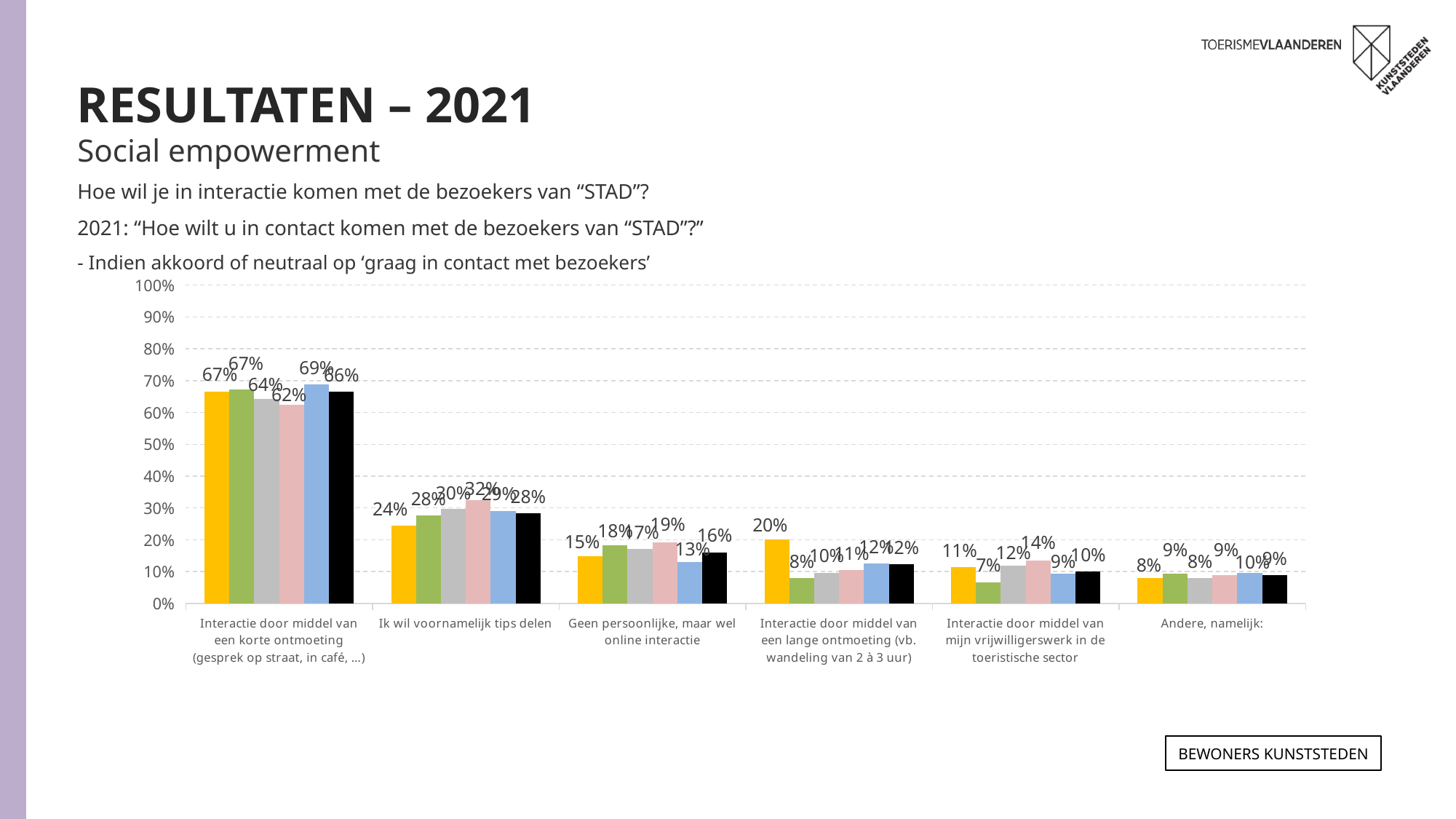
How many bars are plotted for each category in the chart? 6 How many categories are shown along the x axis of the chart? 6 What is the value of the yellow (first) bar for 'Ik wil voornamelijk tips delen'? 24% What is the value of the pink bar for 'Interactie door middel van mijn vrijwilligerswerk in de toeristische sector'? 14% Which category has the highest values across all bars? Interactie door middel van een korte ontmoeting (gesprek op straat, in café, ...) What is the value of the yellow (first) bar for 'Interactie door middel van een lange ontmoeting (vb. wandeling van 2 à 3 uur)'? 20% What is the value of the blue bar for 'Interactie door middel van een korte ontmoeting (gesprek op straat, in café, ...)'? 69% What kind of chart is shown on the slide? bar chart What is the difference between the yellow bar (20%) and the green bar (8%) for 'Interactie door middel van een lange ontmoeting'? 12 percentage points What is the value of the green bar for 'Interactie door middel van mijn vrijwilligerswerk in de toeristische sector'? 7% Which is larger: the yellow bar for 'Ik wil voornamelijk tips delen' or the yellow bar for 'Interactie door middel van een korte ontmoeting'? Interactie door middel van een korte ontmoeting Is the value of the black bar for 'Ik wil voornamelijk tips delen' greater or less than 40%? less